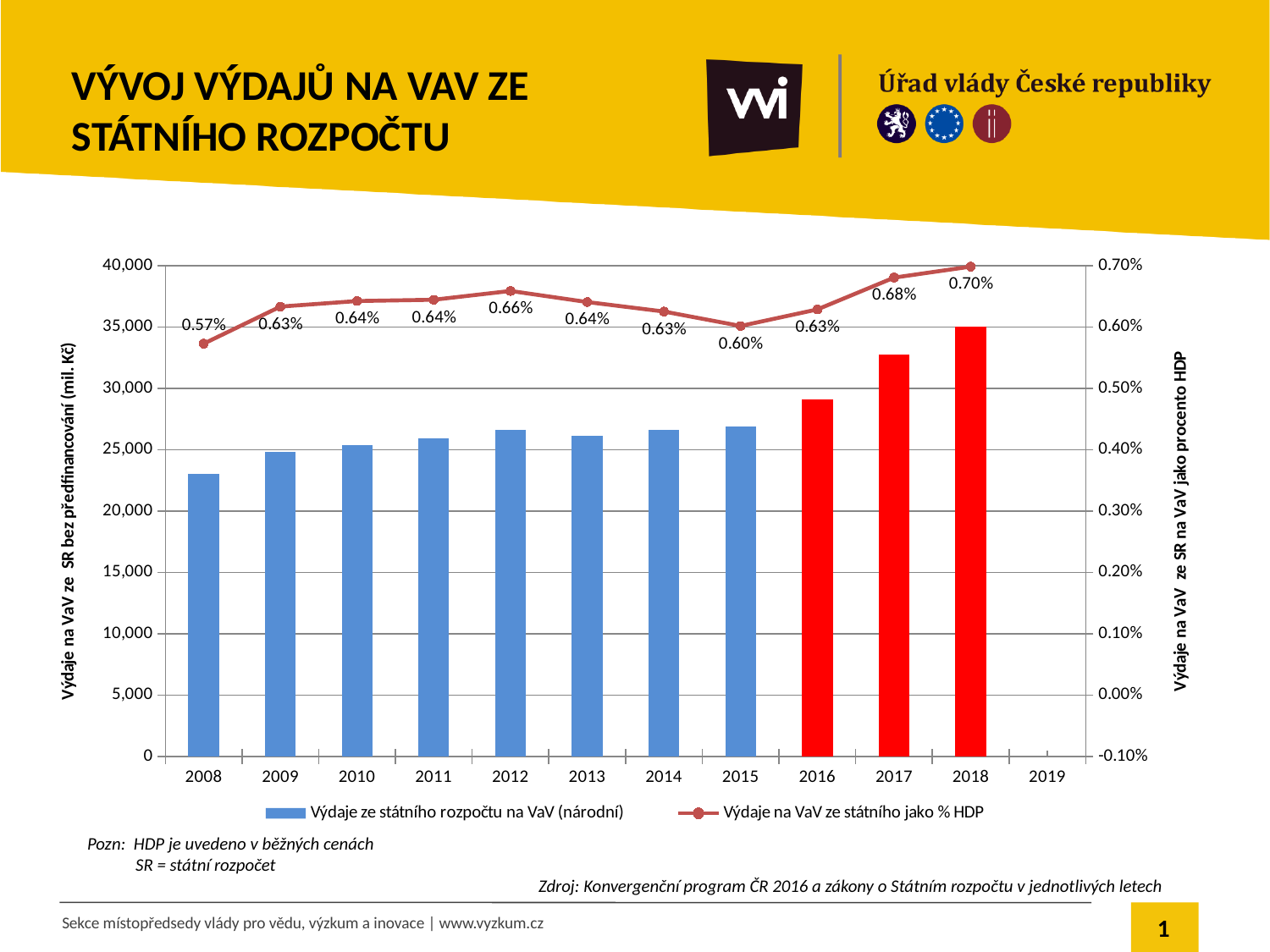
Which year has the larger line series value, 2012 or 2015? 2012 What is the difference between the line series values for 2018 and 2008? 0.13% How many series does the legend list? 2 Is the bar value for 2008 greater or less than 25,000? less In which year is the line series (share of GDP) at its lowest value? 2008 What is the value of the line series for 2015? 0.60% In which year does the line series (share of GDP) reach its highest value? 2018 What colour are the bars for 2016, 2017 and 2018? red What is the value of the line series (Výdaje na VaV ze státního jako % HDP) for 2012? 0.66% Do the bar values generally rise or fall from 2008 to 2018? rise Is the bar value for 2018 greater or less than 30,000? greater Is the bar value for 2016 greater or less than 30,000? less